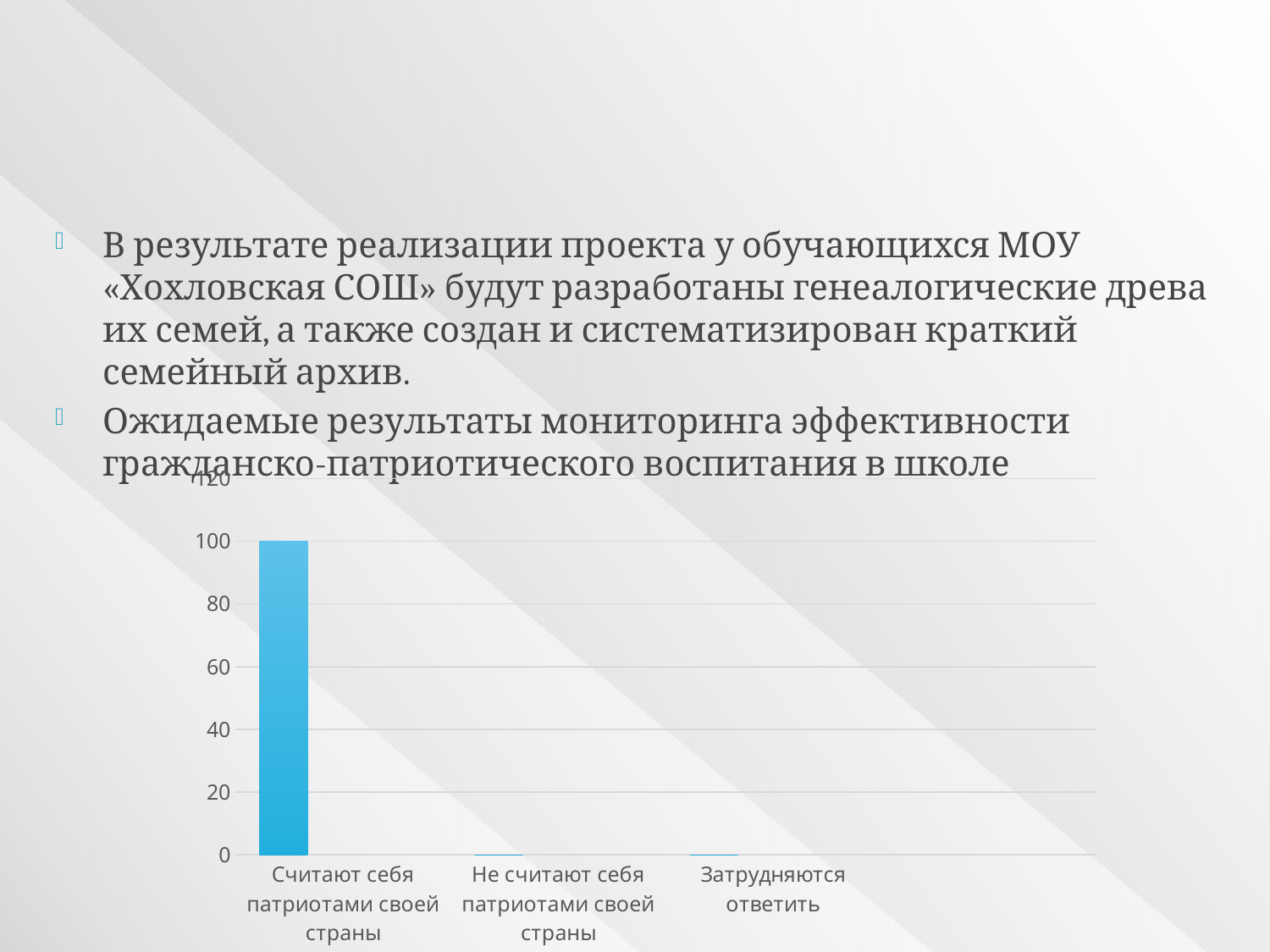
What colour are the bars in the chart? blue Is the value for "Не считают себя патриотами своей страны" greater or less than 20? less Is the value for "Считают себя патриотами своей страны" greater or less than 80? greater Which category has the highest value? Считают себя патриотами своей страны Do the values rise or fall from the first category to the last along the x axis? fall What is the highest value shown on the y axis? 120 Is the value for "Затрудняются ответить" greater or less than 20? less What kind of chart is shown on the slide? bar chart How many categories are shown on the x axis of the chart? 3 What is the value for "Считают себя патриотами своей страны"? 100 Which is larger: the value for "Считают себя патриотами своей страны" or the value for "Затрудняются ответить"? Считают себя патриотами своей страны